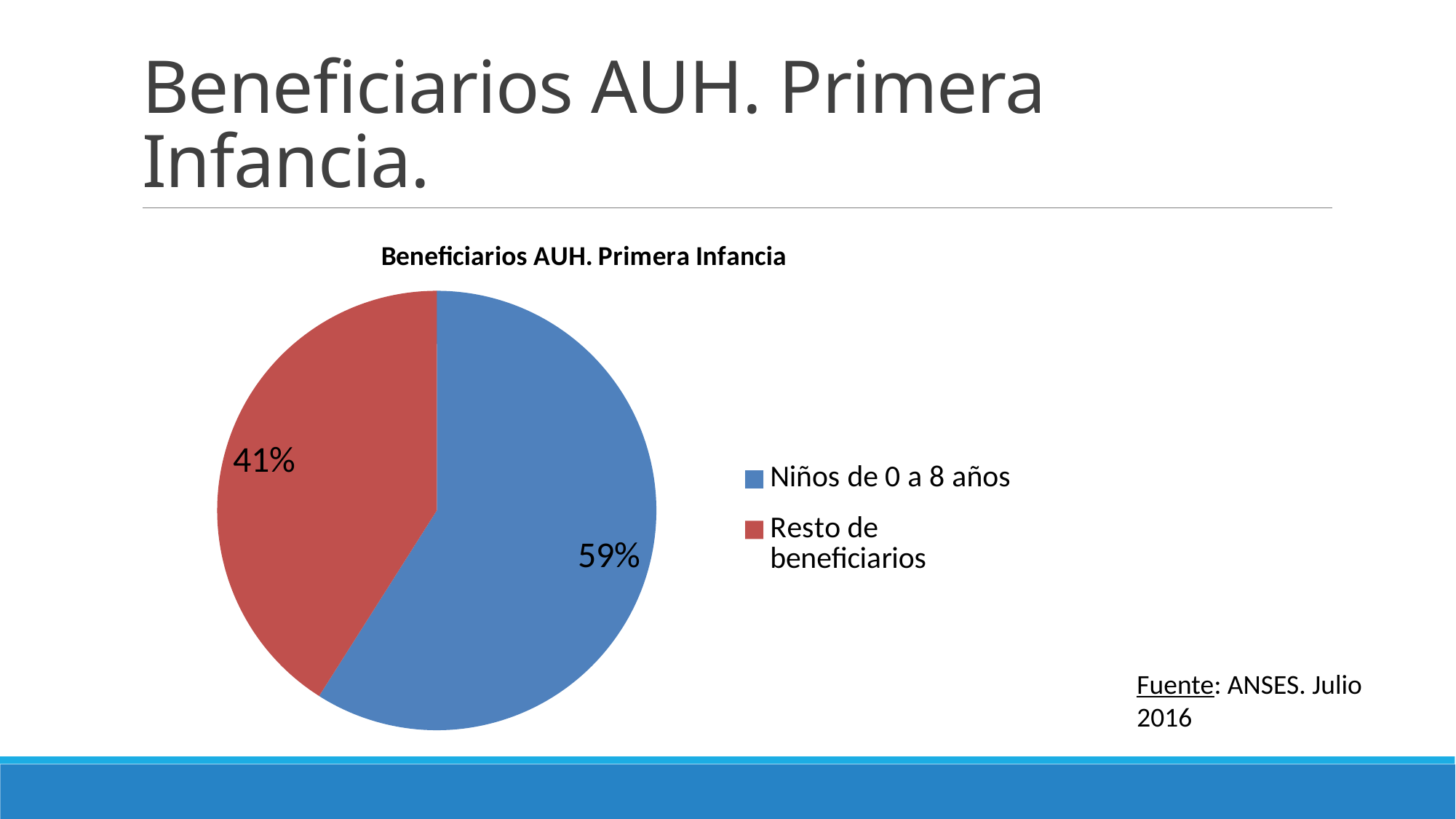
Which category has the largest slice of the pie? Niños de 0 a 8 años What is the difference in percentage points between the "Niños de 0 a 8 años" slice and the "Resto de beneficiarios" slice? 18 percentage points What kind of chart is shown on the slide? Pie chart Which is larger: the share for "Niños de 0 a 8 años" or the share for "Resto de beneficiarios"? Niños de 0 a 8 años Which category has the smallest slice of the pie? Resto de beneficiarios How many categories are shown in the pie chart? 2 What is the title of the chart? Beneficiarios AUH. Primera Infancia What share of the pie does "Resto de beneficiarios" represent? 41% What colour is the slice for "Resto de beneficiarios"? Red What share of the pie does "Niños de 0 a 8 años" represent? 59%